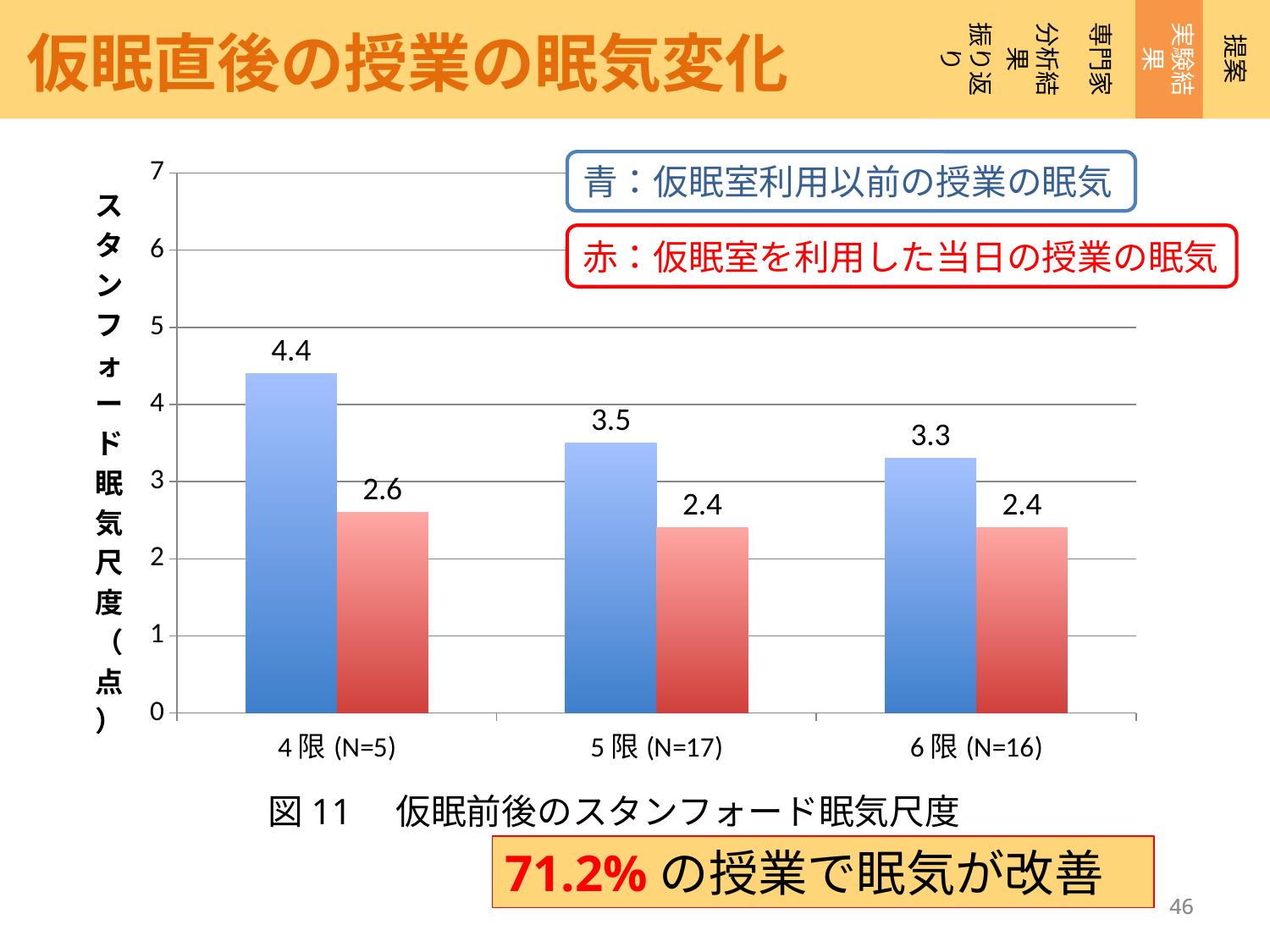
What is the difference between the blue and red bar values for 5限 (N=17)? 1.1 Which category has the lowest blue bar value? 6限 (N=16) What is the difference between the blue and red bar values for 4限 (N=5)? 1.8 How many categories are shown on the x axis? 3 What kind of chart is shown on the slide? bar chart Do the blue bar values rise or fall from 4限 to 6限? fall What is the red bar value for 4限 (N=5)? 2.6 Which is larger for 6限 (N=16), the blue bar or the red bar? the blue bar What is the red bar value for 5限 (N=17)? 2.4 What is the blue bar value for 4限 (N=5)? 4.4 Which category has the highest blue bar value? 4限 (N=5) What is the blue bar value for 6限 (N=16)? 3.3